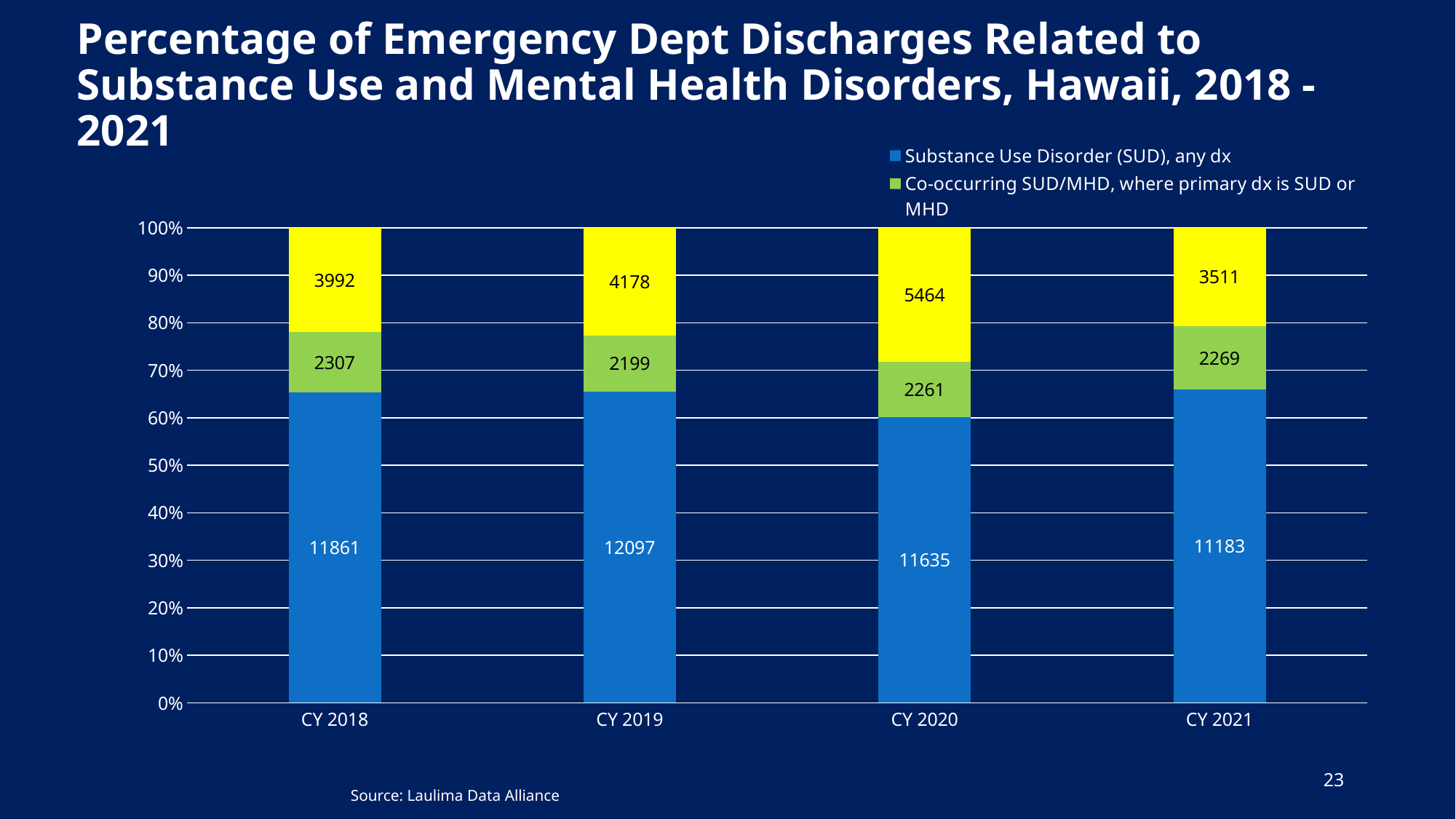
What kind of chart is shown on the slide? Stacked bar chart What is the difference between the Substance Use Disorder (SUD), any dx values for CY 2018 and CY 2021? 678 What is the value of the Co-occurring SUD/MHD segment for CY 2020? 2261 What is the value shown in the yellow top segment of the CY 2020 bar? 5464 Is the share of the Substance Use Disorder (SUD), any dx segment for CY 2020 greater or less than 70%? less Which year has the larger Co-occurring SUD/MHD value, CY 2018 or CY 2021? CY 2018 How many years are shown on the x axis? 4 What is the total of the three labelled segments in the CY 2018 bar? 18160 How many series does the legend list? 2 Which year has the lowest value for Substance Use Disorder (SUD), any dx? CY 2021 What is the value of the Substance Use Disorder (SUD), any dx segment for CY 2019? 12097 Which year has the highest value for Substance Use Disorder (SUD), any dx? CY 2019